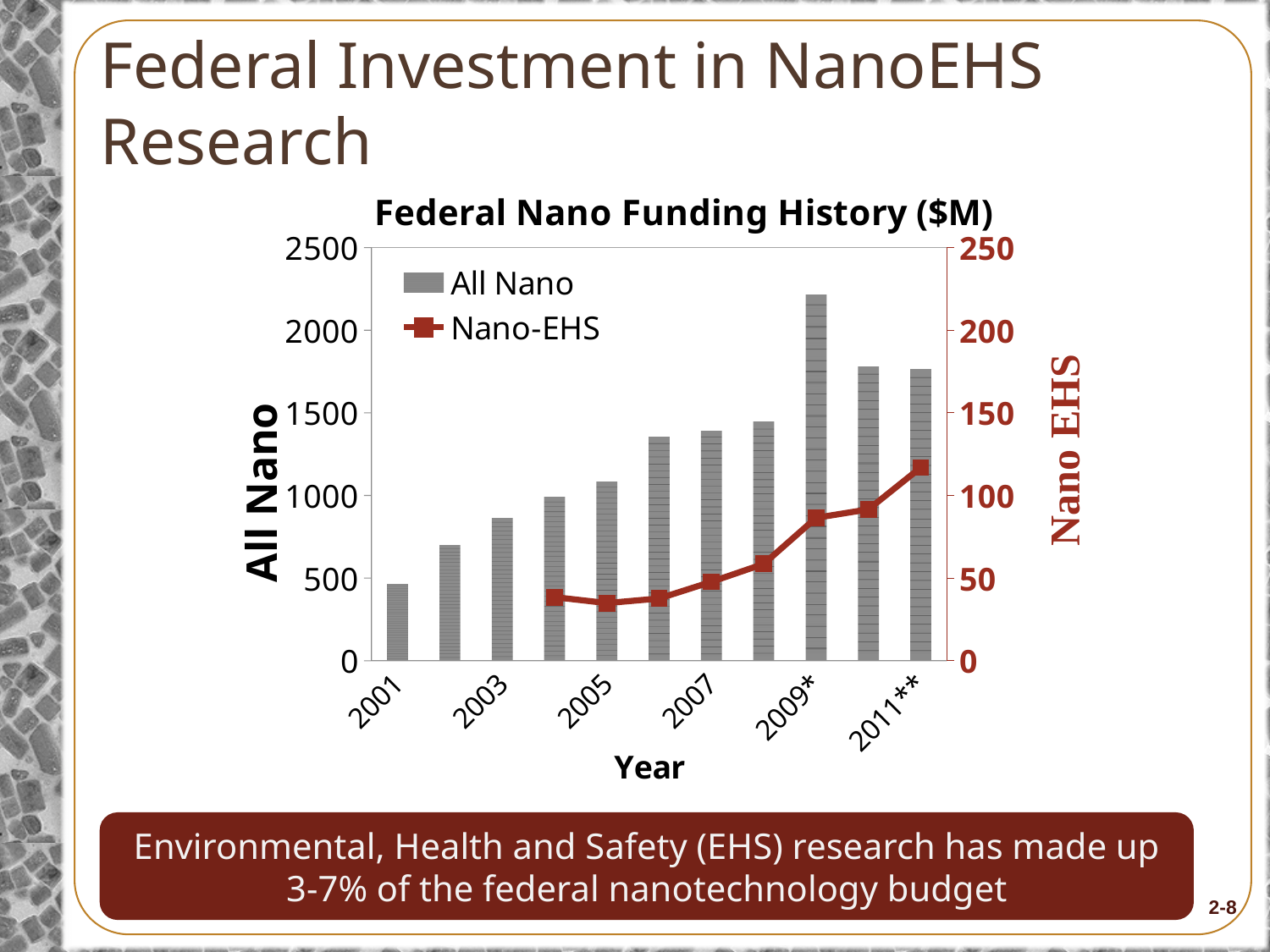
Does the Nano-EHS line generally rise or fall from 2005 to 2011**? rise How many bars are plotted for the All Nano series? 11 What kind of chart is shown on the slide? A bar chart combined with a line chart Which year has the highest All Nano bar? 2009* Which is larger, the All Nano bar for 2009* or the All Nano bar for 2011**? 2009* Is the All Nano value for 2009* greater or less than 2000? greater Which year has the lowest All Nano bar? 2001 How many series does the legend list? 2 Is the All Nano value for 2001 greater or less than 500? less Is the Nano-EHS value for 2011** greater or less than 100? greater What is the title of the chart? Federal Nano Funding History ($M)